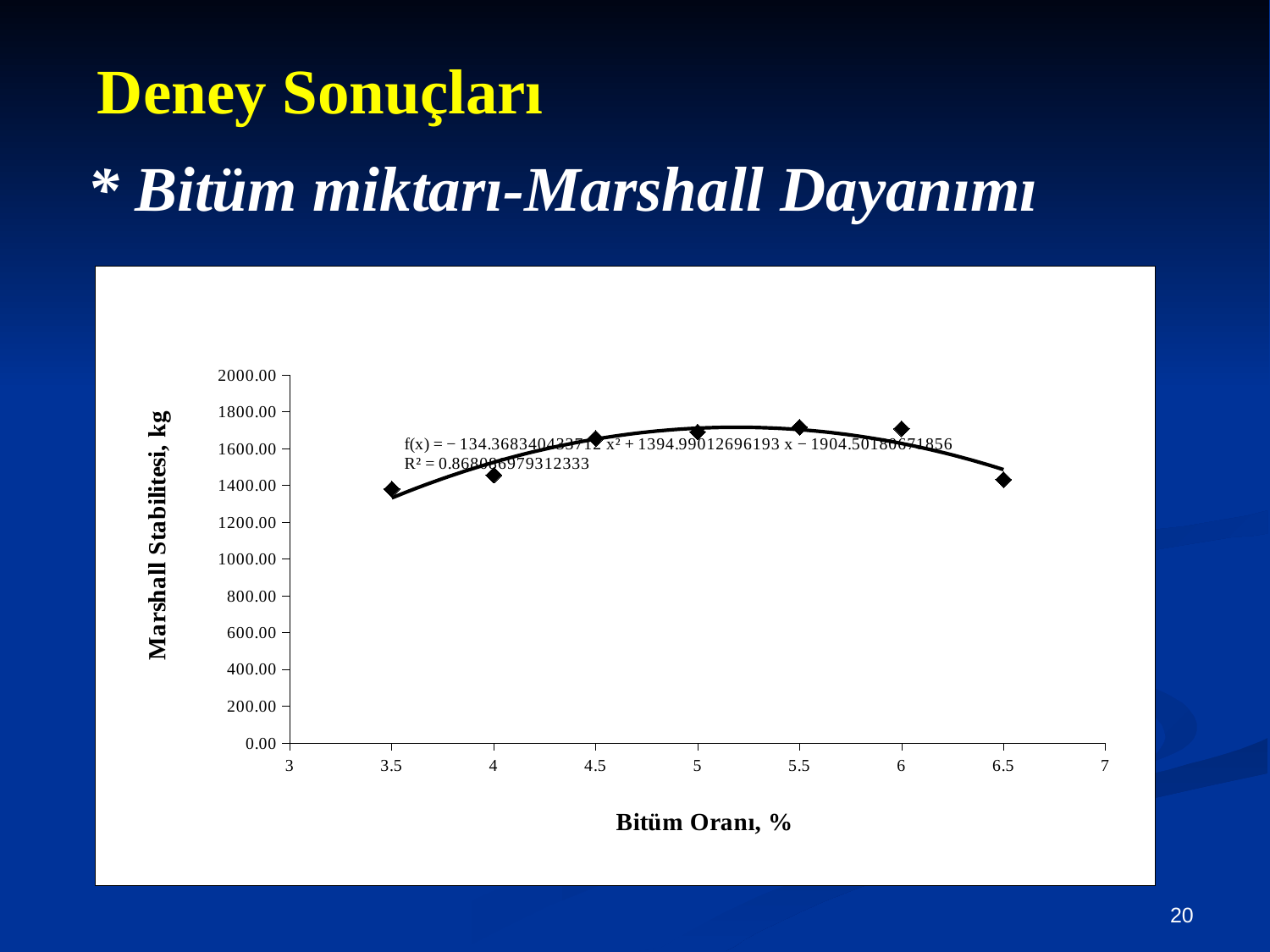
Which bitumen ratio has the higher Marshall stability, 4 or 6? 6 Is the Marshall stability value at a bitumen ratio of 6 greater or less than 1800? less Which bitumen ratio has the higher Marshall stability, 3.5 or 5? 5 What is the title of the x axis? Bitüm Oranı, % Is the Marshall stability value at a bitumen ratio of 6.5 greater or less than 1600? less What kind of chart is shown on the slide? scatter chart What is the title of the y axis? Marshall Stabilitesi, kg Is the Marshall stability value at a bitumen ratio of 5 greater or less than 1600? greater How many data points are plotted on the chart? 7 How do the Marshall stability values change as the bitumen ratio increases from 3.5 to 6.5? they rise, then fall